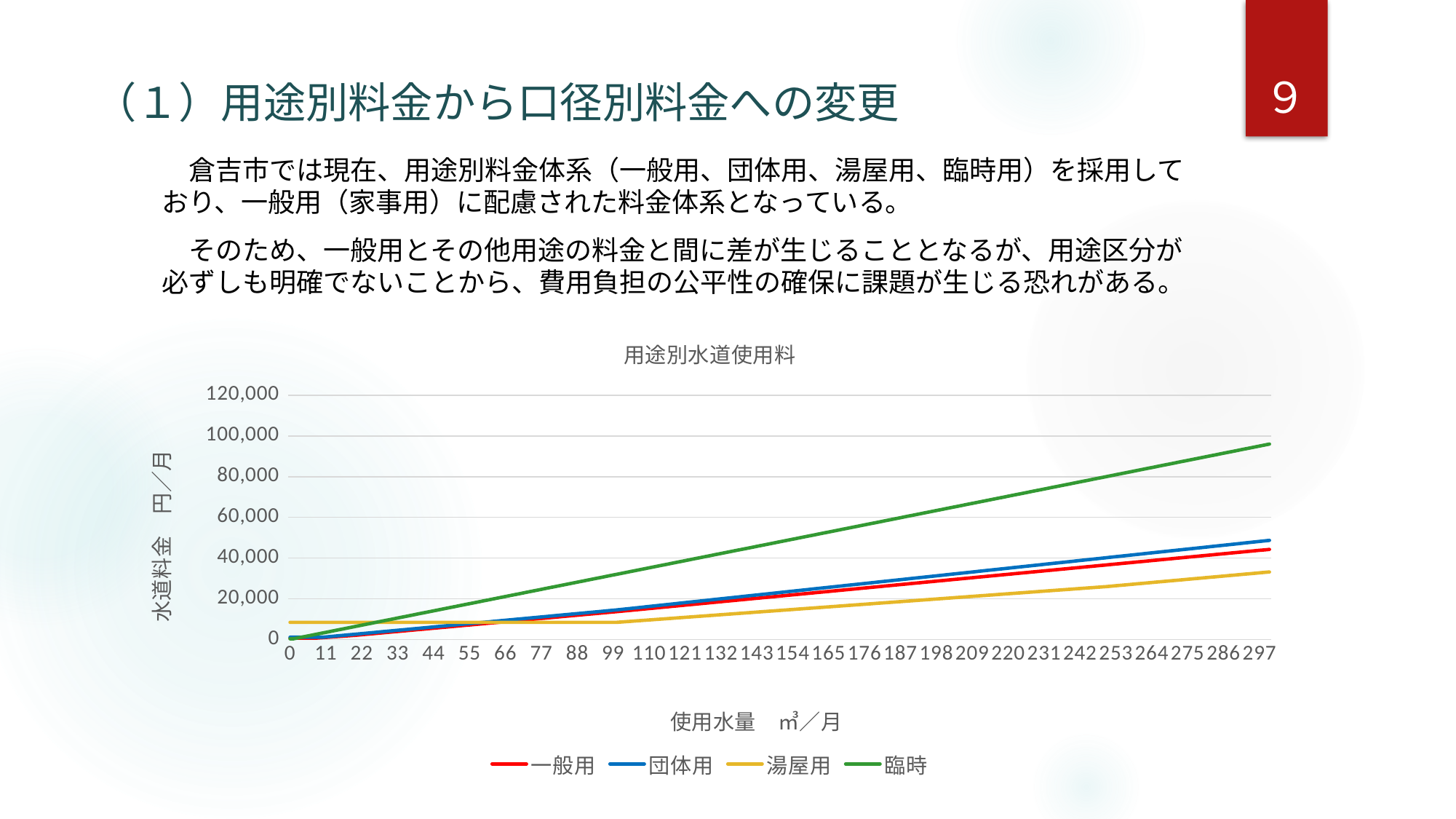
Do the values for 臨時 rise or fall as the water usage on the x axis increases? rise Is the value for 団体用 at 297 ㎥／月 greater or less than 60,000? less What kind of chart is shown on the slide? line chart What is the label of the y axis of the chart? 水道料金 円／月 What is the title of the chart? 用途別水道使用料 How many series does the legend of the chart list? 4 Which series has the lowest value at 297 ㎥／月? 湯屋用 Is the value for 臨時 at 297 ㎥／月 greater or less than 80,000? greater At 297 ㎥／月, which is larger: the value for 臨時 or the value for 一般用? 臨時 Which series has the highest value at 297 ㎥／月? 臨時 Is the value for 湯屋用 at 297 ㎥／月 greater or less than 40,000? less How many tick labels are shown on the x axis of the chart? 28